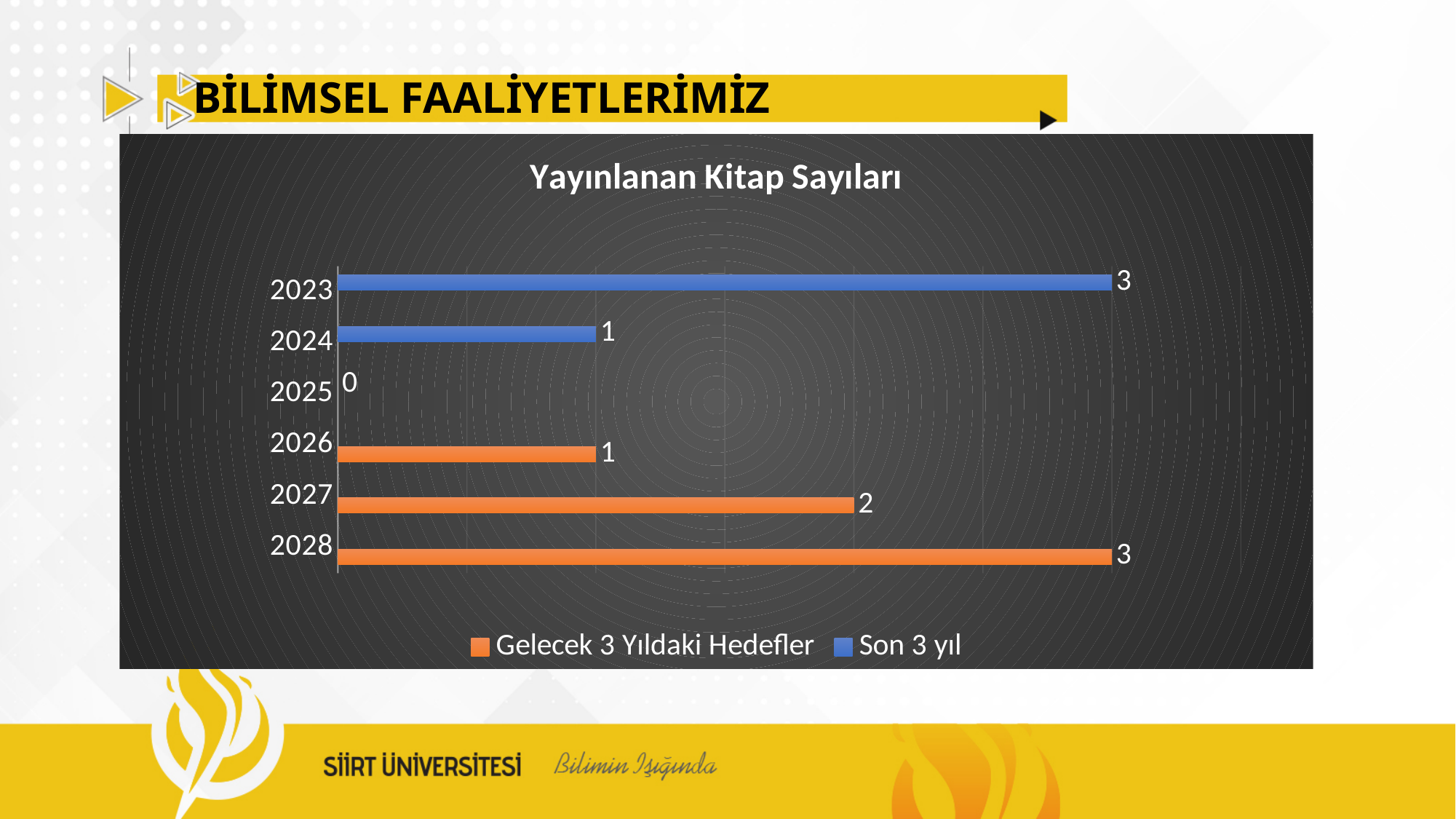
Which year has the lowest value on the chart? 2025 What is the value for 2025? 0 What type of chart is shown on the slide? bar chart What is the title of the chart? Yayınlanan Kitap Sayıları How many series does the legend list? 2 What is the difference between the values for 2028 and 2026? 2 What is the value for 2024? 1 What is the value for 2027 in the Gelecek 3 Yıldaki Hedefler series? 2 Which is larger, the value for 2027 or the value for 2024? 2027 What is the value for 2028 in the Gelecek 3 Yıldaki Hedefler series? 3 What is the value for 2023? 3 How many year categories are shown on the chart? 6